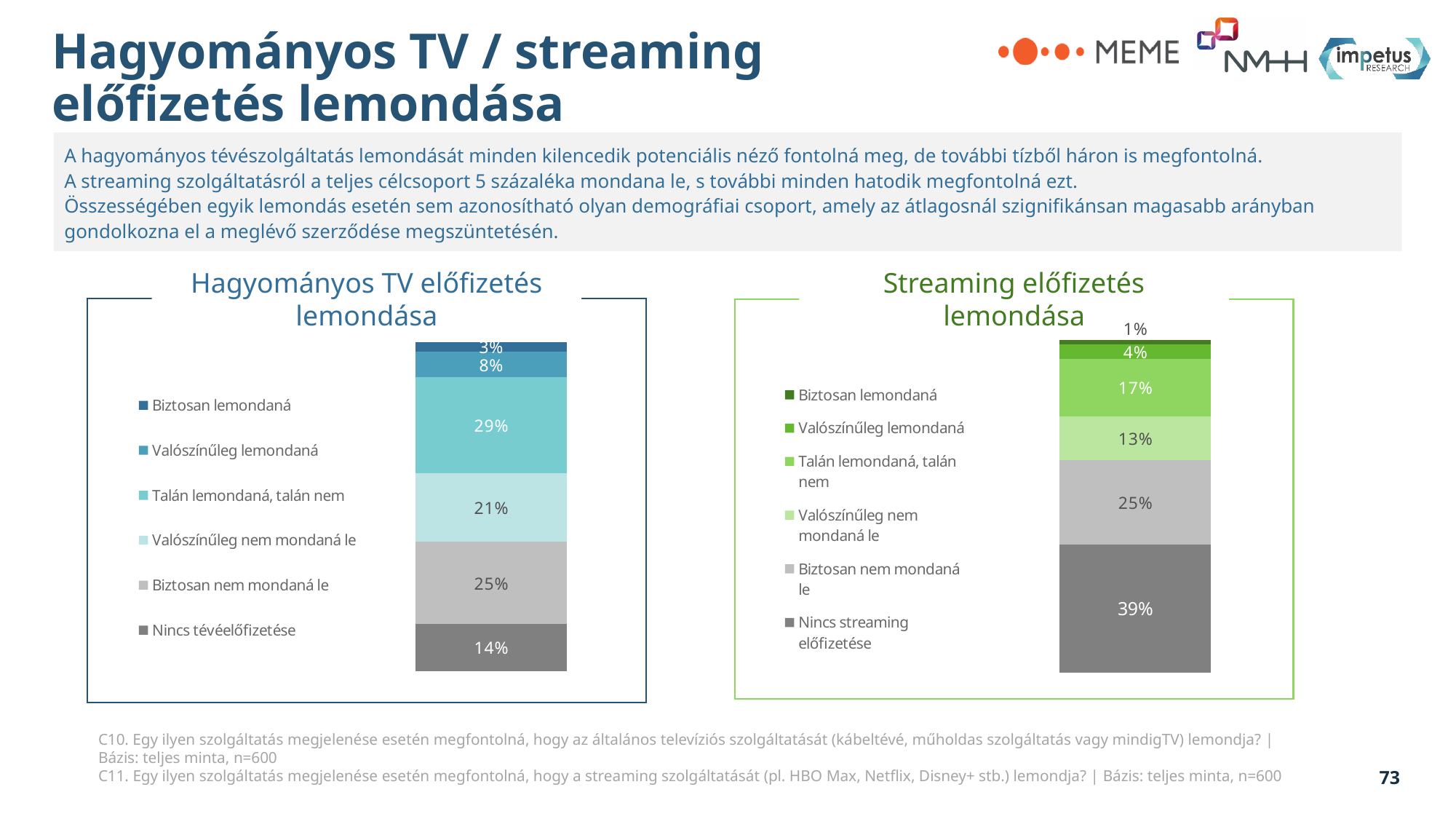
In the 'Streaming előfizetés lemondása' chart, which segment has the largest value? Nincs streaming előfizetése How many series does the legend of the 'Streaming előfizetés lemondása' chart list? 6 In the 'Streaming előfizetés lemondása' chart, what is the difference between 'Talán lemondaná, talán nem' and 'Valószínűleg lemondaná'? 13 percentage points What kind of chart is the 'Hagyományos TV előfizetés lemondása' chart? Stacked bar chart In the 'Hagyományos TV előfizetés lemondása' chart, what is the difference between 'Biztosan nem mondaná le' and 'Nincs tévéelőfizetése'? 11 percentage points Which is larger: 'Valószínűleg lemondaná' in the 'Hagyományos TV előfizetés lemondása' chart or 'Valószínűleg lemondaná' in the 'Streaming előfizetés lemondása' chart? Hagyományos TV előfizetés lemondása In the 'Streaming előfizetés lemondása' chart, what is the value for 'Valószínűleg nem mondaná le'? 13% In the 'Streaming előfizetés lemondása' chart, what is the value for 'Nincs streaming előfizetése'? 39% In the 'Hagyományos TV előfizetés lemondása' chart, what is the value for 'Biztosan lemondaná'? 3% In the 'Hagyományos TV előfizetés lemondása' chart, which segment has the smallest value? Biztosan lemondaná In the 'Hagyományos TV előfizetés lemondása' chart, what is the total of the stacked bar? 100% In the 'Hagyományos TV előfizetés lemondása' chart, what is the value for 'Talán lemondaná, talán nem'? 29%